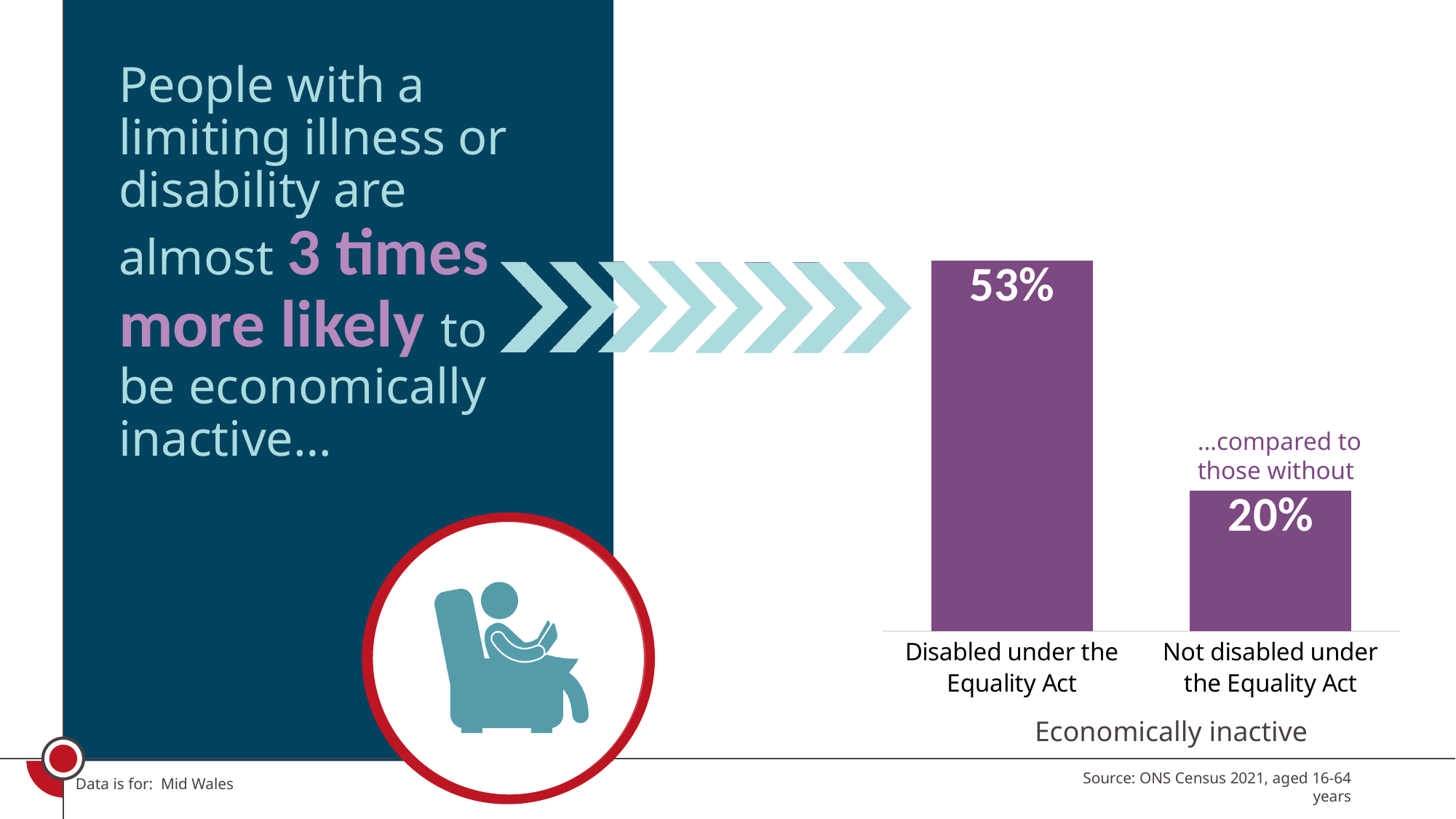
What is the value for 'Not disabled under the Equality Act'? 20% What is the title shown below the chart's categories? Economically inactive Which category has the lowest value? Not disabled under the Equality Act How many categories are shown in the chart? 2 What kind of chart is shown on the slide? Bar chart What is the value for 'Disabled under the Equality Act'? 53% What colour are the bars in the chart? Purple What is the source of the data shown in the chart? ONS Census 2021, aged 16-64 years Which is larger: the value for 'Disabled under the Equality Act' or 'Not disabled under the Equality Act'? Disabled under the Equality Act What is the difference between the values for 'Disabled under the Equality Act' and 'Not disabled under the Equality Act'? 33% Which category has the highest value? Disabled under the Equality Act